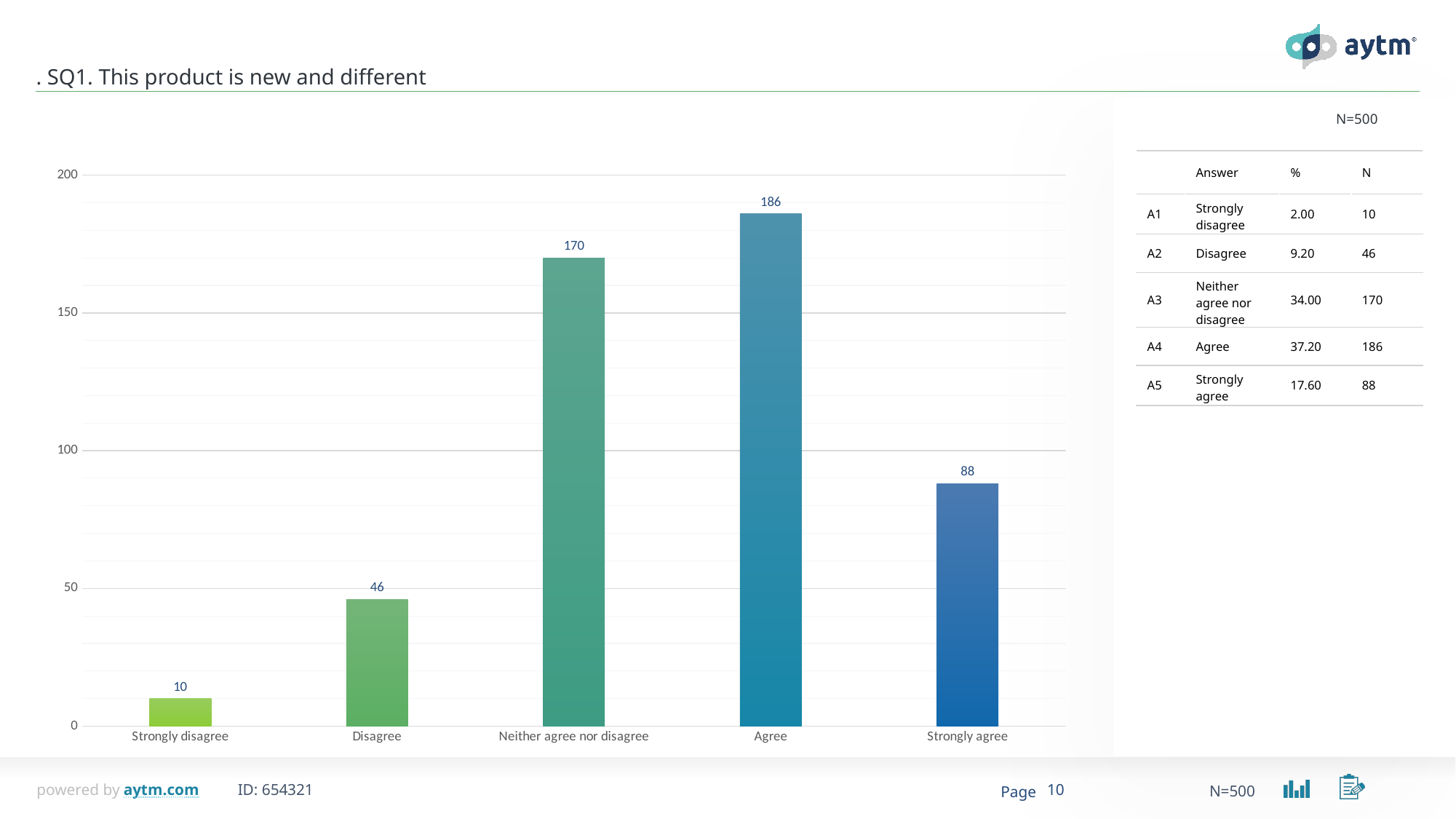
Which category has the highest value? Agree What is the difference between the values for Strongly agree and Disagree? 42 What is the value for Strongly disagree? 10 Is the value for Strongly agree greater or less than 100? less How many categories are shown on the x axis? 5 Which is larger, the value for Strongly agree or the value for Disagree? Strongly agree What is the difference between the values for Agree and Neither agree nor disagree? 16 What kind of chart is shown on the slide? bar chart What is the title of the chart? SQ1. This product is new and different What is the value for Agree? 186 Which category has the lowest value? Strongly disagree What is the value for Neither agree nor disagree? 170